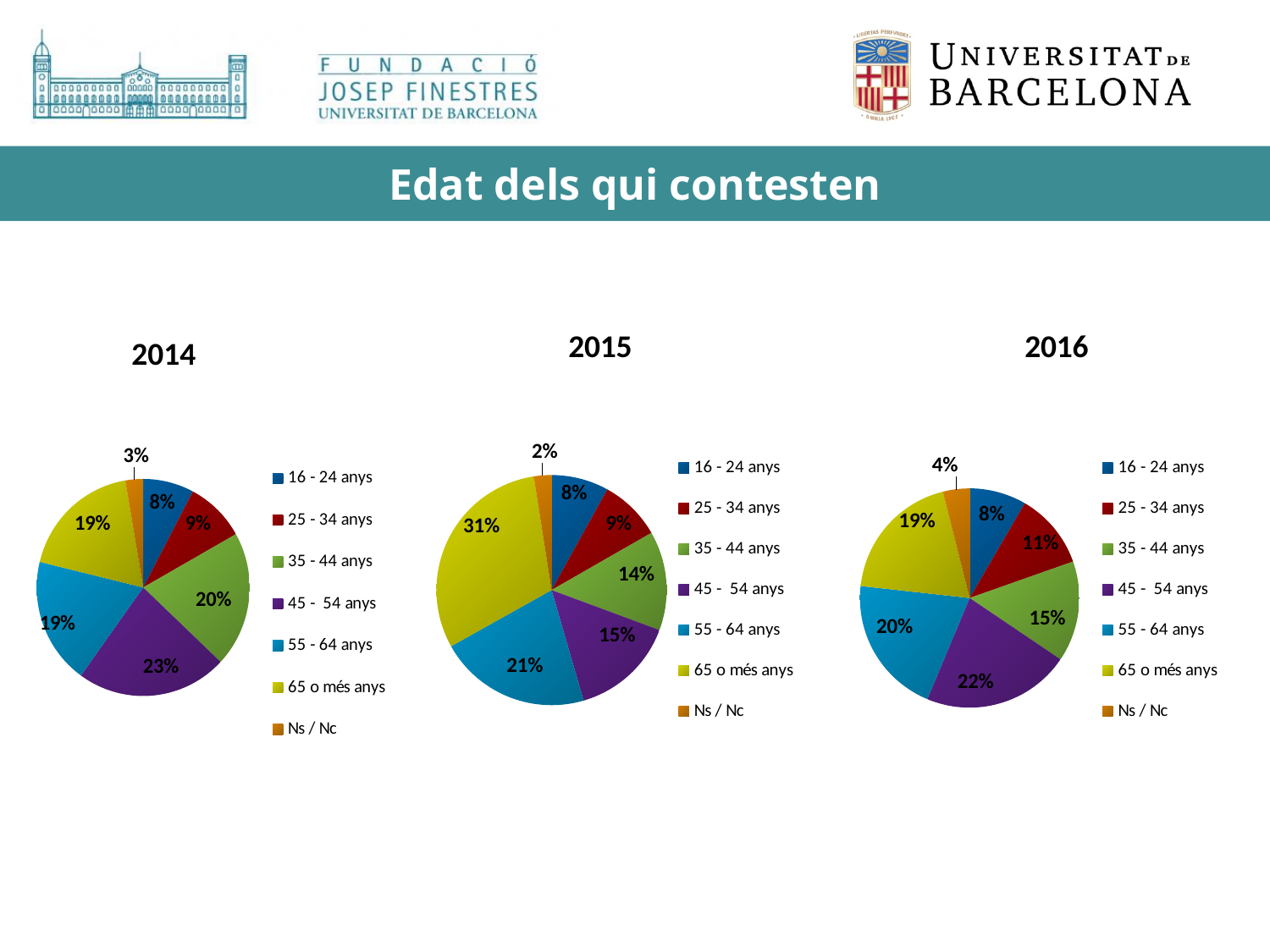
In the 2016 chart, which age group has the largest share? 45 - 54 anys What is the title of the slide? Edat dels qui contesten In the 2016 chart, what share of respondents are 25 - 34 anys? 11% What kind of chart is used for the 2014 data? Pie chart In the 2016 chart, what share of respondents answered Ns / Nc? 4% In the 2014 chart, which category has the smallest share? Ns / Nc In the 2015 chart, what is the difference between the 65 o més anys share and the 55 - 64 anys share? 10% In the 2015 chart, which age group has the largest share? 65 o més anys In the 2014 chart, which is larger: the share for 35 - 44 anys or the share for 45 - 54 anys? 45 - 54 anys In the 2015 chart, what share of respondents are 65 o més anys? 31% In the 2014 chart, what share of respondents are 45 - 54 anys? 23% How many categories does the legend of the 2015 chart list? 7